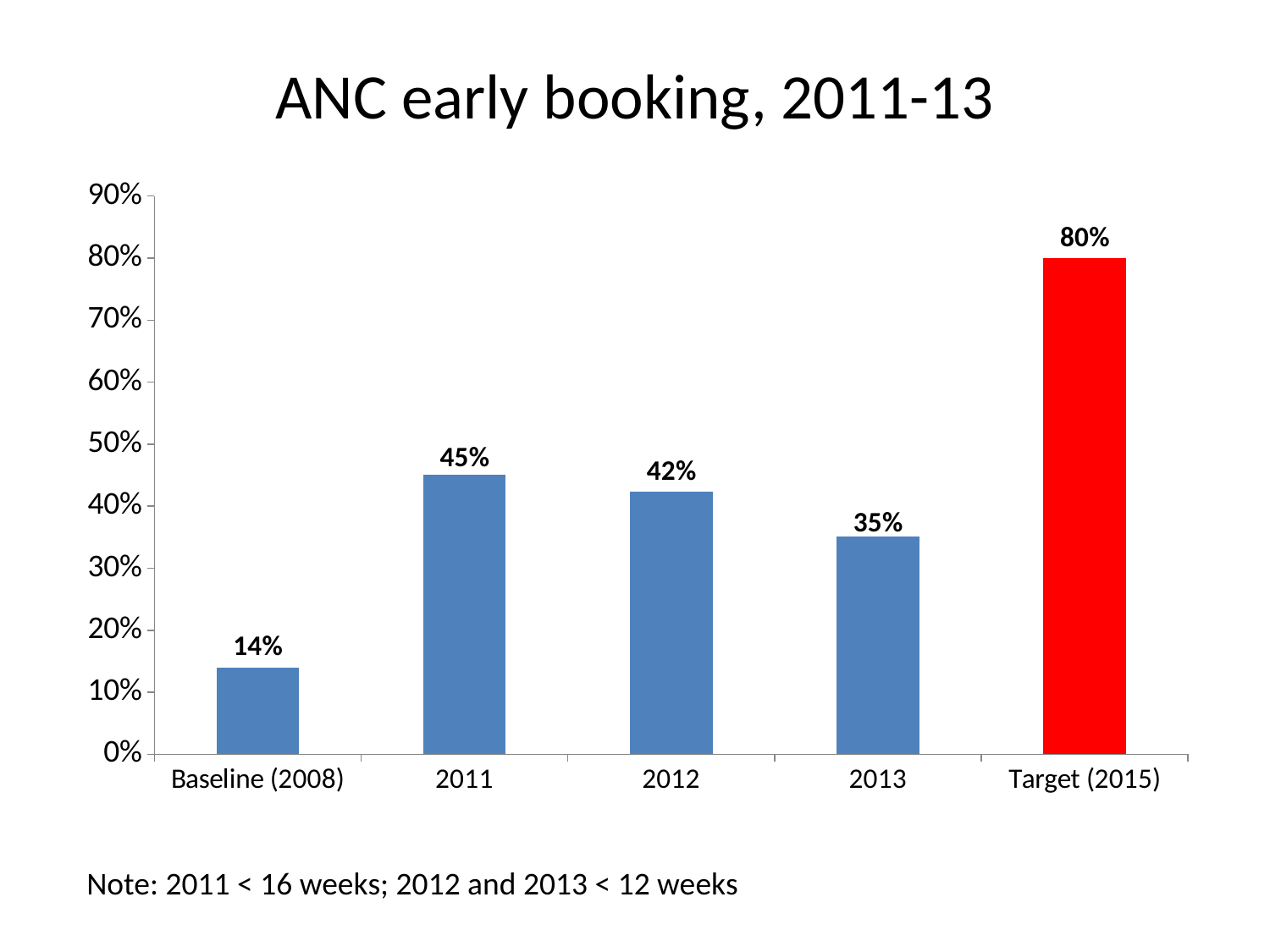
What is the value for 2013? 35% What kind of chart is this? Bar chart Do the values rise or fall from 2011 to 2013? Fall What is the value for Target (2015)? 80% Which category has the lowest value? Baseline (2008) Which is larger, the value for 2011 or the value for 2013? 2011 What is the difference between the 2011 value and the 2012 value? 3% What is the value for Baseline (2008)? 14% How many categories are shown on the x axis? 5 Which category has the highest value? Target (2015) What is the difference between the Target (2015) value and the 2013 value? 45% What is the title of the chart? ANC early booking, 2011-13